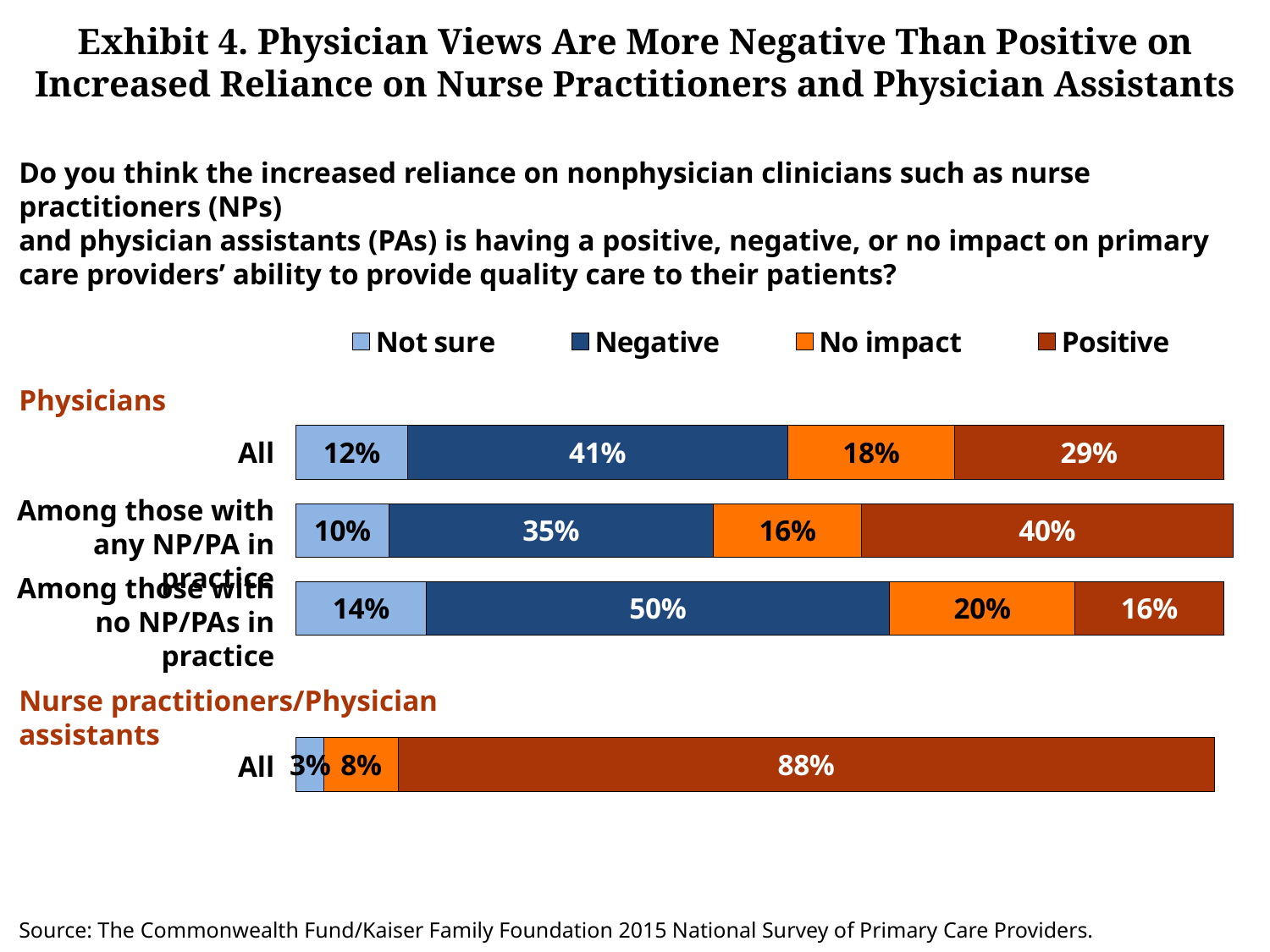
Is the 'No impact' share larger for physicians with no NP/PAs in practice or for those with any NP/PA in practice? Those with no NP/PAs in practice Which group has the highest share saying the impact is negative? Among those with no NP/PAs in practice How many series does the legend list? 4 How many bars are shown in the chart? 4 Among physicians with no NP/PAs in practice, what percentage say the impact is negative? 50% Which group has the lowest share saying the impact is positive? Among those with no NP/PAs in practice What percentage of all nurse practitioners/physician assistants say the impact is positive? 88% What percentage of all physicians are not sure about the impact? 12% What is the difference between the negative and positive shares for all physicians? 12 percentage points Among physicians with any NP/PA in practice, what percentage say the impact is positive? 40% What percentage of all physicians say the increased reliance on NPs/PAs has a negative impact? 41% What kind of chart is shown on the slide? Stacked bar chart